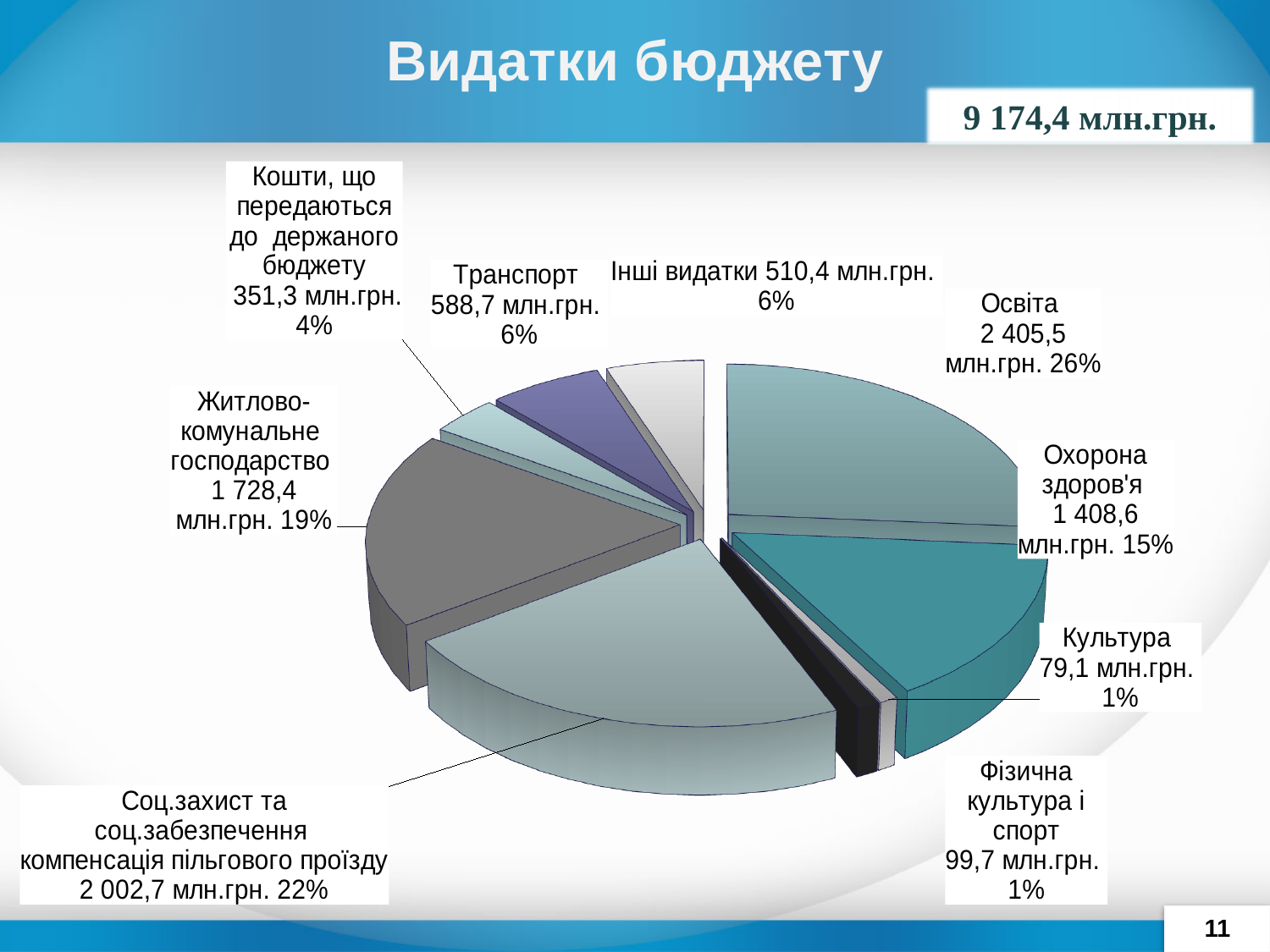
What is the title of the chart? Видатки бюджету Which is larger, the value for Транспорт or the value for Інші видатки? Транспорт How many categories (slices) does the pie chart have? 9 What share of the pie does Охорона здоров'я represent? 15% What is the value for Транспорт? 588,7 млн.грн. Which category has the largest share of the pie? Освіта What is the value for Житлово-комунальне господарство? 1 728,4 млн.грн. Which category has the smallest value? Культура What is the value for Освіта? 2 405,5 млн.грн. What is the difference between the values for Освіта and Соц.захист та соц.забезпечення компенсація пільгового проїзду? 402,8 млн.грн. What kind of chart is shown on the slide? pie chart What share of the pie does Соц.захист та соц.забезпечення компенсація пільгового проїзду represent? 22%